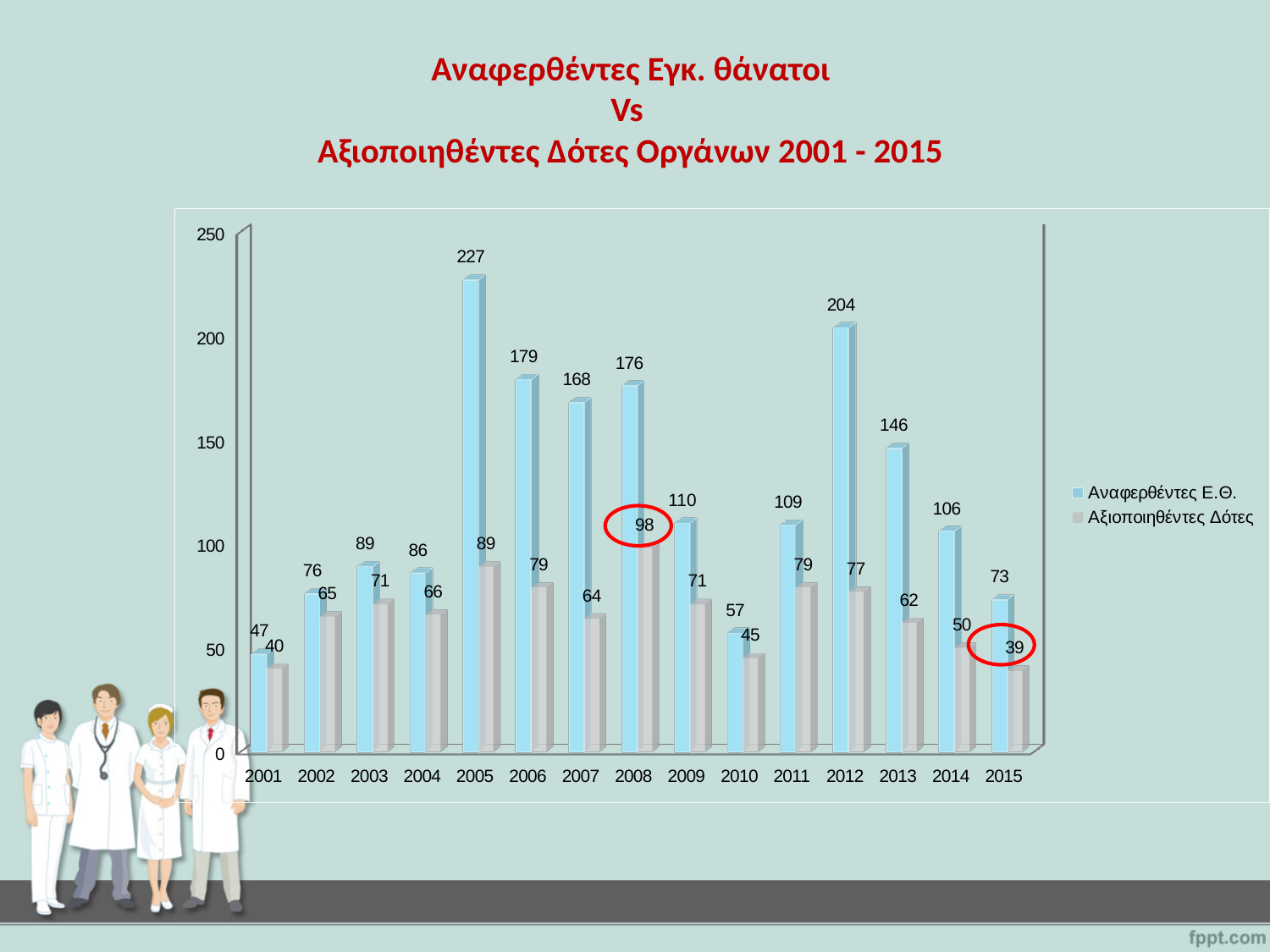
How many years are shown on the x axis? 15 Is the value for Αναφερθέντες Ε.Θ. in 2013 greater or less than 150? less What is the value for Αξιοποιηθέντες Δότες in 2015? 39 Which series is shown in blue in the legend? Αναφερθέντες Ε.Θ. Which is larger: Αναφερθέντες Ε.Θ. in 2006 or in 2007? 2006 In which year is the value for Αναφερθέντες Ε.Θ. highest? 2005 What is the value for Αξιοποιηθέντες Δότες in 2008? 98 What is the value for Αναφερθέντες Ε.Θ. in 2005? 227 What is the difference between Αναφερθέντες Ε.Θ. and Αξιοποιηθέντες Δότες in 2012? 127 In which year is the value for Αξιοποιηθέντες Δότες lowest? 2015 How many series does the legend list? 2 What type of chart is shown on the slide? bar chart